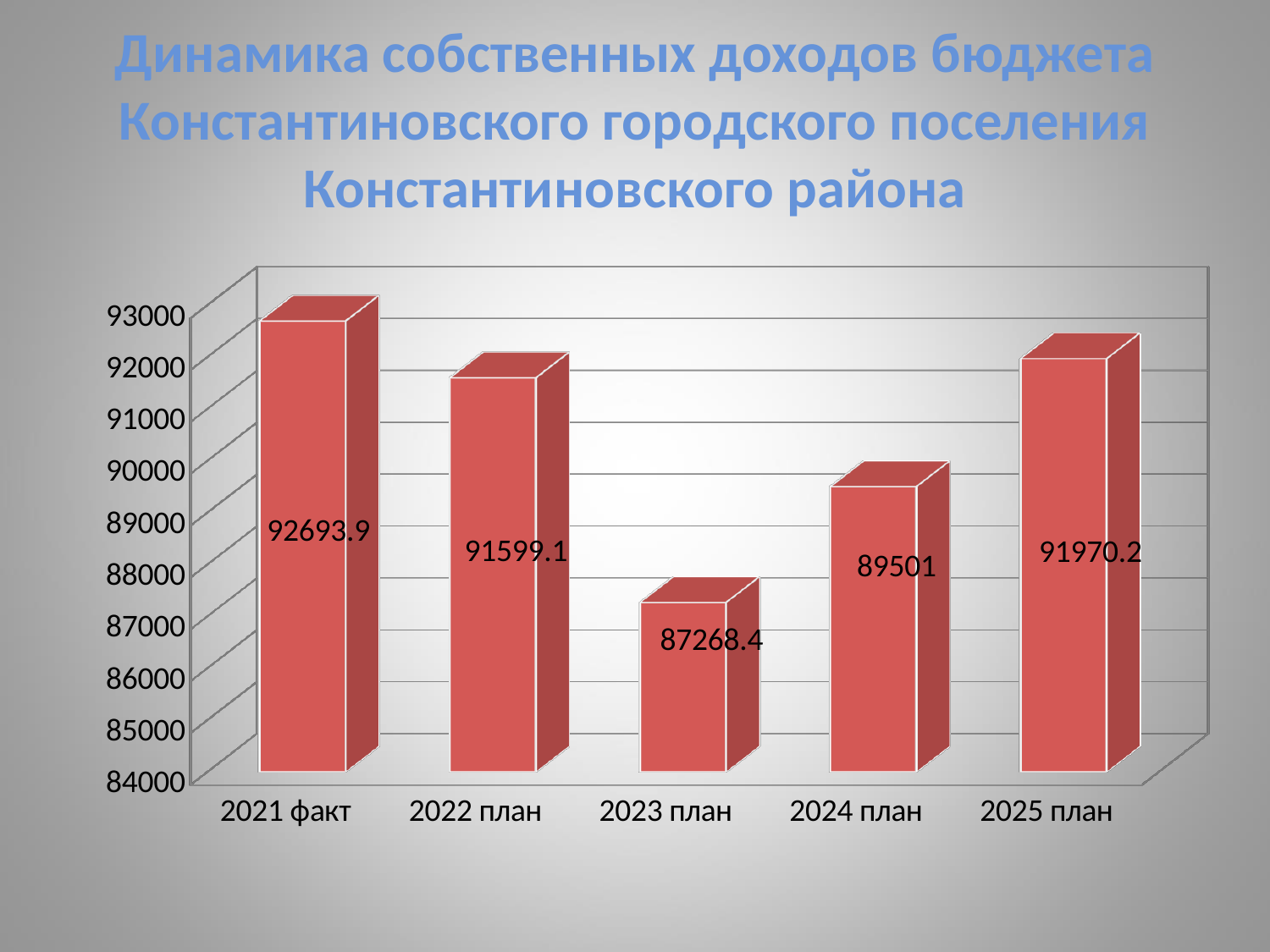
What is the difference between the values for 2021 факт and 2022 план? 1094.8 What kind of chart is shown on the slide? bar chart What is the value for 2025 план? 91970.2 Which is larger, the value for 2022 план or the value for 2025 план? 2025 план Which category has the highest value? 2021 факт Which category has the lowest value? 2023 план What is the value for 2021 факт? 92693.9 What is the difference between the values for 2025 план and 2024 план? 2469.2 Is the value for 2024 план greater or less than 90000? less What is the value for 2024 план? 89501 How many categories are shown on the x axis? 5 What is the value for 2023 план? 87268.4